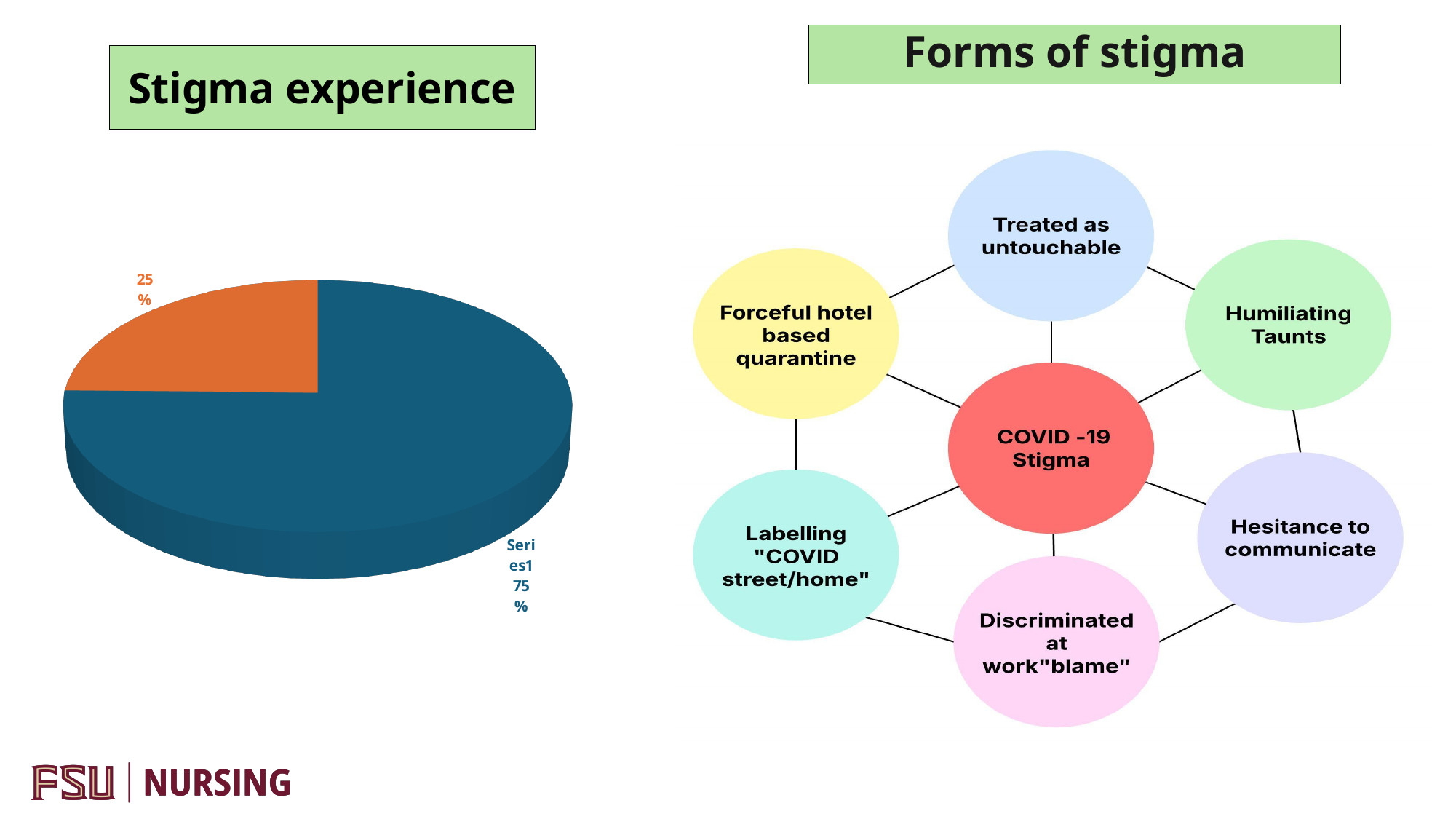
In the "Stigma experience" pie chart, what share of the pie does the orange slice represent? 25% In the "Stigma experience" pie chart, what is the difference in percentage points between the blue slice and the orange slice? 50 In the "Stigma experience" pie chart, which is larger, the blue slice or the orange slice? the blue slice In the "Stigma experience" pie chart, which slice is the largest? the blue slice (75%) What series name is printed next to the blue slice of the "Stigma experience" pie chart? Series1 In the "Stigma experience" pie chart, what percentage is shown on the blue slice? 75% What is the title shown above the pie chart on the left of the slide? Stigma experience What kind of chart is shown under the heading "Stigma experience"? pie chart In the "Stigma experience" pie chart, what percentage is shown on the orange slice? 25% How many slices does the "Stigma experience" pie chart have? 2 In the "Stigma experience" pie chart, what share of the pie does the blue slice represent? 75% In the "Stigma experience" pie chart, which slice is the smallest? the orange slice (25%)